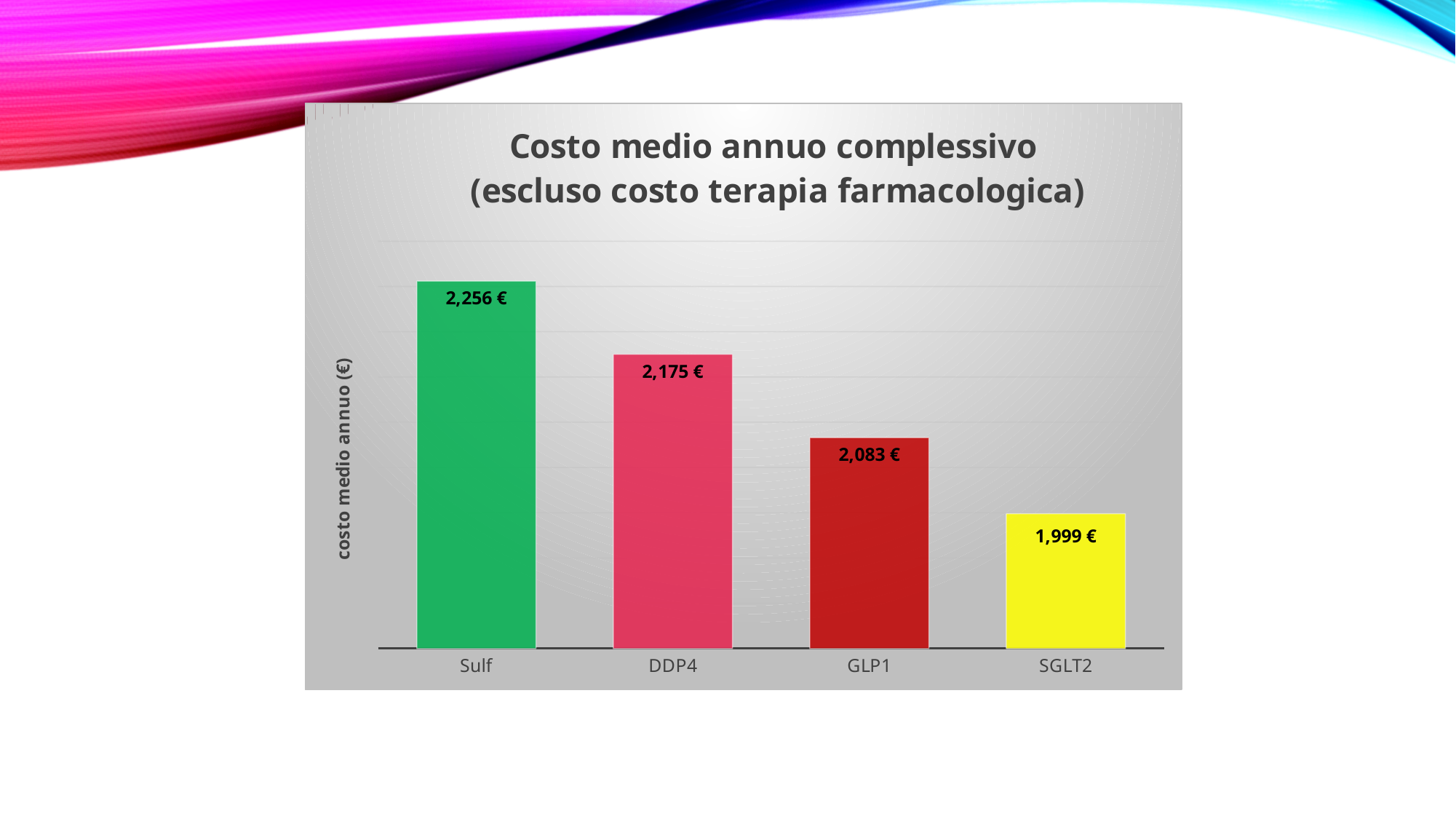
What is the value for SGLT2? 1,999 € How many categories are shown on the x axis? 4 What kind of chart is this? Bar chart Do the values rise or fall from left to right along the x axis? Fall Which category has the highest value? Sulf What is the value for DDP4? 2,175 € What is the difference between the values for Sulf and SGLT2? 257 € What is the difference between the values for DDP4 and GLP1? 92 € What is the value for GLP1? 2,083 € What is the value for Sulf? 2,256 € Which category has the lowest value? SGLT2 Which is larger, the value for DDP4 or the value for GLP1? DDP4